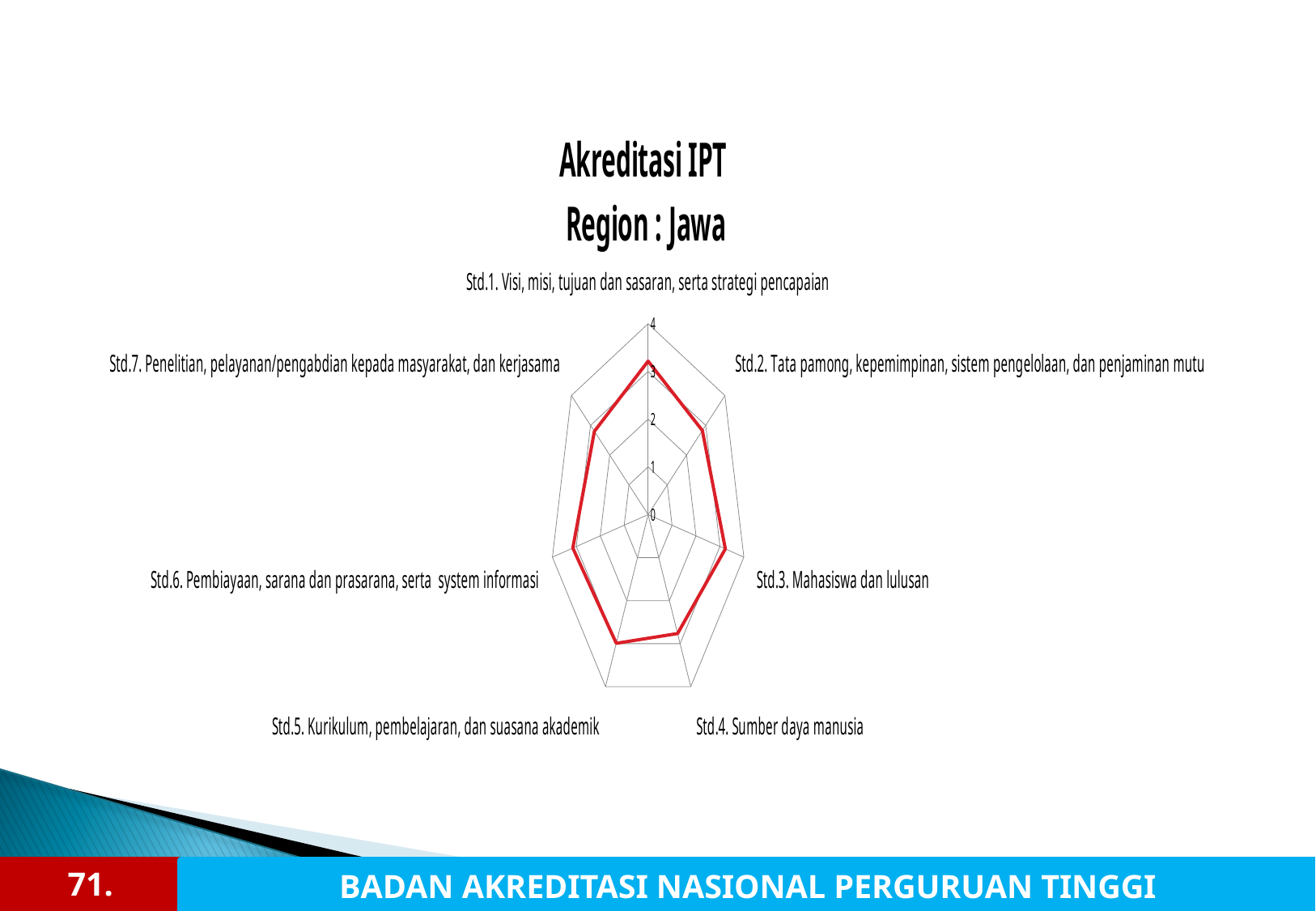
What kind of chart is shown on the slide? Radar chart Is the value for Std.4 (Sumber daya manusia) greater or less than 1? greater Which region does the chart refer to? Jawa Is the value for Std.1 (Visi, misi, tujuan dan sasaran, serta strategi pencapaian) greater or less than 2? greater Is the value for Std.3 (Mahasiswa dan lulusan) greater or less than 4? less How many standards (categories) are plotted on the radar chart? 7 What is the maximum value shown on the chart's axis scale? 4 What is the title of the chart? Akreditasi IPT Region : Jawa How many data series are plotted on the radar chart? 1